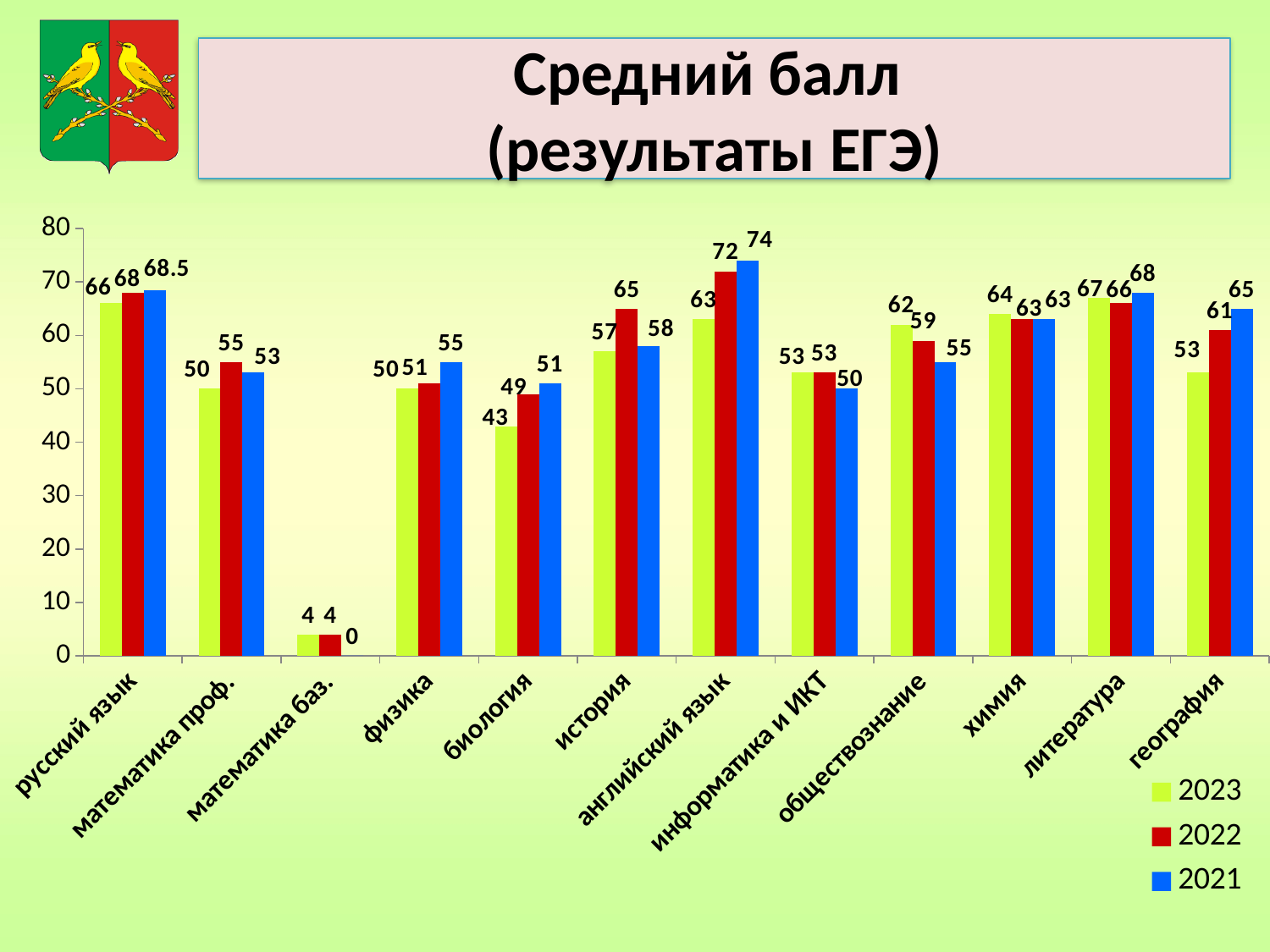
How many series does the legend list? 3 Which is larger for география: the 2021 value or the 2023 value? 2021 What kind of chart is shown on the slide? bar chart How many categories are shown on the x axis? 12 What is the value for русский язык in the 2021 series? 68.5 Which category has the highest value in the 2021 series? английский язык What is the value for английский язык in the 2022 series? 72 Which category has the lowest value in the 2023 series? математика баз. What is the difference between the 2022 and 2023 values for история? 8 What is the value for биология in the 2023 series? 43 What is the title of the chart? Средний балл (результаты ЕГЭ) Which colour represents the 2022 series in the legend? red